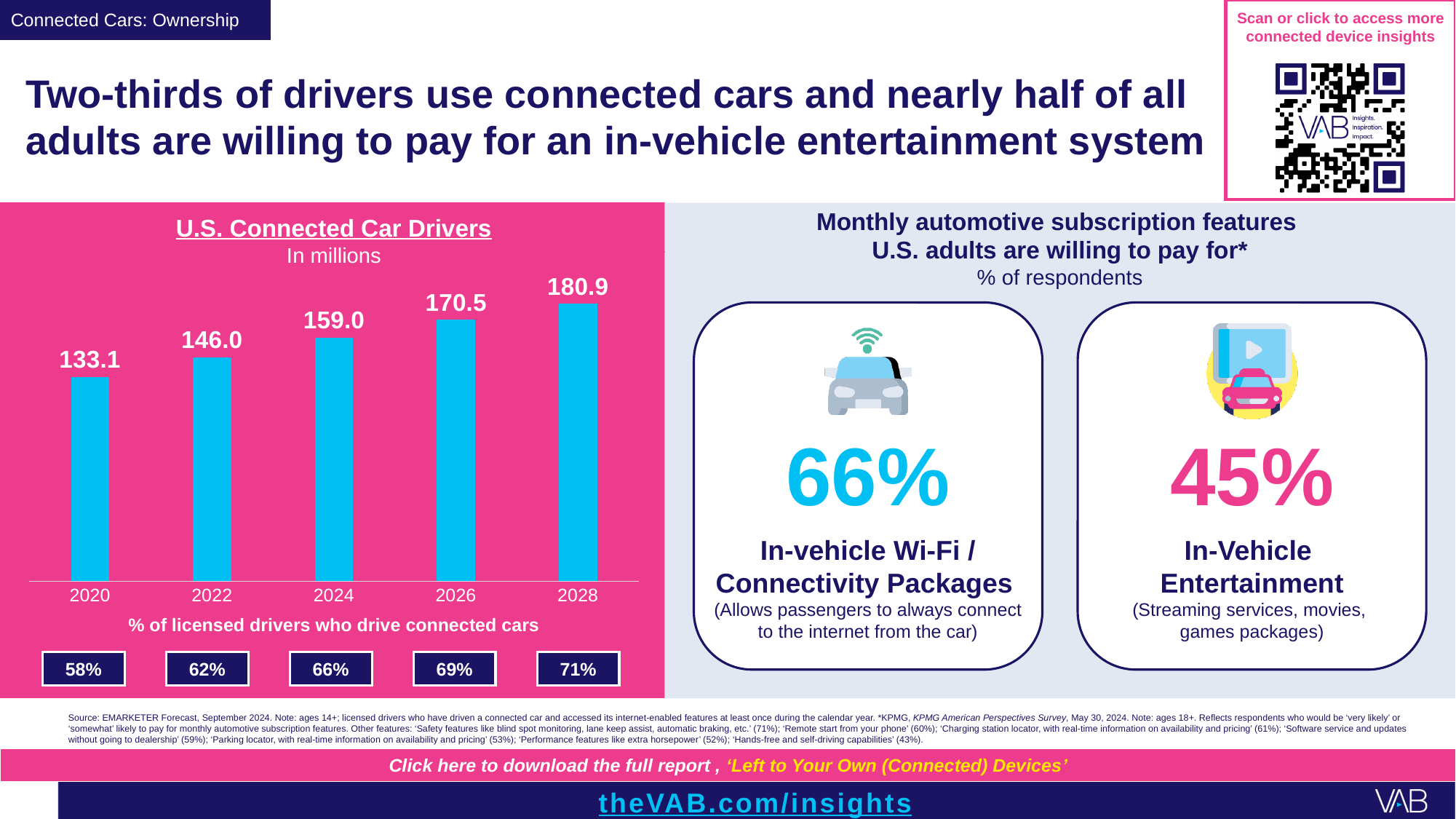
In the 'U.S. Connected Car Drivers' chart, which year has the lowest value? 2020 How many years are shown in the 'U.S. Connected Car Drivers' chart? 5 In the 'U.S. Connected Car Drivers' chart, do the values rise or fall from 2020 to 2028? Rise In the 'U.S. Connected Car Drivers' chart, what is the difference between the 2028 and 2020 values? 47.8 In the 'U.S. Connected Car Drivers' chart, what percentage of licensed drivers drive connected cars in 2028? 71% In the 'U.S. Connected Car Drivers' chart, what is the value for 2020? 133.1 In the 'U.S. Connected Car Drivers' chart, what is the difference between the 2026 and 2024 values? 11.5 In the 'U.S. Connected Car Drivers' chart, which year has the highest value? 2028 In the 'U.S. Connected Car Drivers' chart, which is larger, the value for 2022 or the value for 2026? 2026 What unit is the 'U.S. Connected Car Drivers' chart measured in, according to its subtitle? In millions What kind of chart is the 'U.S. Connected Car Drivers' chart? Bar chart In the 'U.S. Connected Car Drivers' chart, what is the value for 2024? 159.0